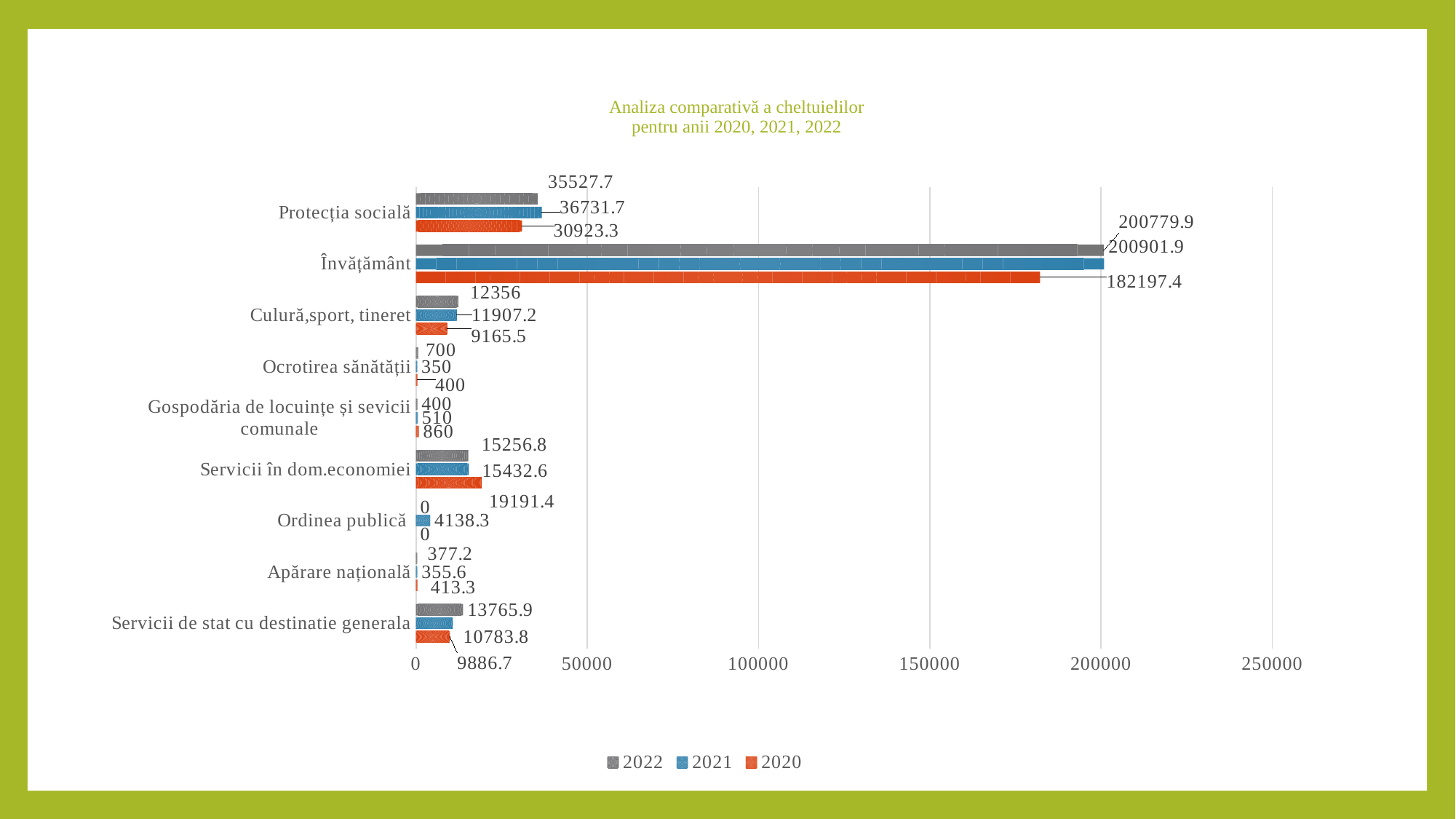
How many categories are plotted on the chart? 9 How many series does the legend list? 3 For Servicii în dom.economiei, which year has the larger value, 2020 or 2022? 2020 Which category has the highest value for 2022? Învățământ What is the value for Protecția socială in 2021? 36731.7 What is the value for Învățământ in 2020? 182197.4 Is the value for Învățământ in 2021 greater or less than 150000? greater What is the value for Ocrotirea sănătății in 2022? 700 What is the value for Ordinea publică in 2021? 4138.3 What kind of chart is shown on the slide? bar chart What is the difference between the 2021 and 2020 values for Protecția socială? 5808.4 What is the title of the chart? Analiza comparativă a cheltuielilor pentru anii 2020, 2021, 2022